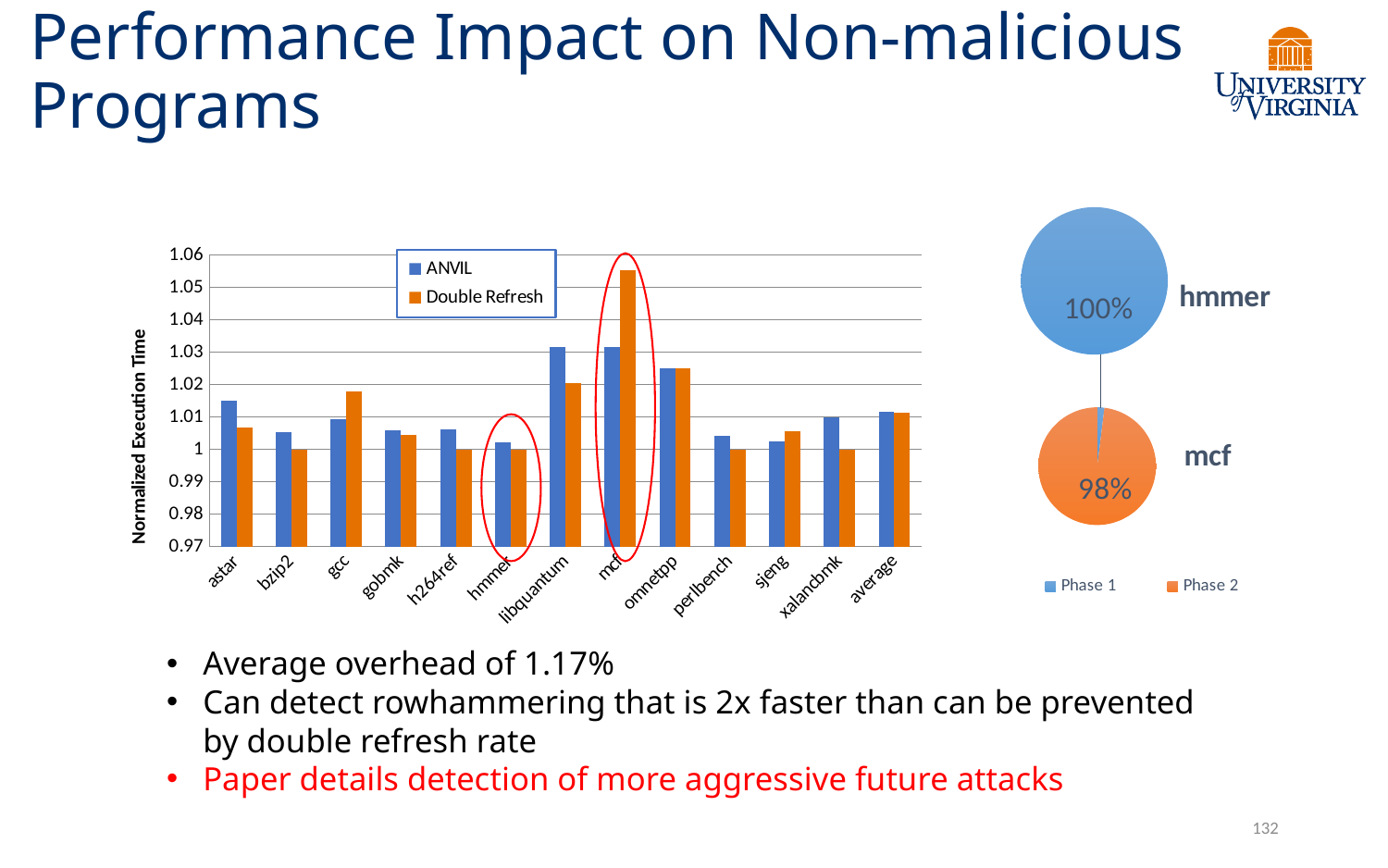
In the bar chart on the left, which is larger for gcc: the ANVIL value or the Double Refresh value? Double Refresh What kind of chart is the chart on the left showing Normalized Execution Time? bar chart In the bar chart on the left, is the ANVIL value for astar greater or less than 1.02? less In the pie chart labelled mcf on the right, what share is shown for Phase 2? 98% In the bar chart on the left, how many categories are shown on the x axis? 13 In the bar chart on the left, what is the label of the y axis? Normalized Execution Time In the bar chart on the left, how many series does the legend list? 2 In the bar chart on the left, which category has the highest Double Refresh value? mcf In the bar chart on the left, which is larger for xalancbmk: the ANVIL value or the Double Refresh value? ANVIL In the pie chart labelled hmmer on the right, what share is shown for Phase 1? 100% In the bar chart on the left, is the Double Refresh value for mcf greater or less than 1.05? greater